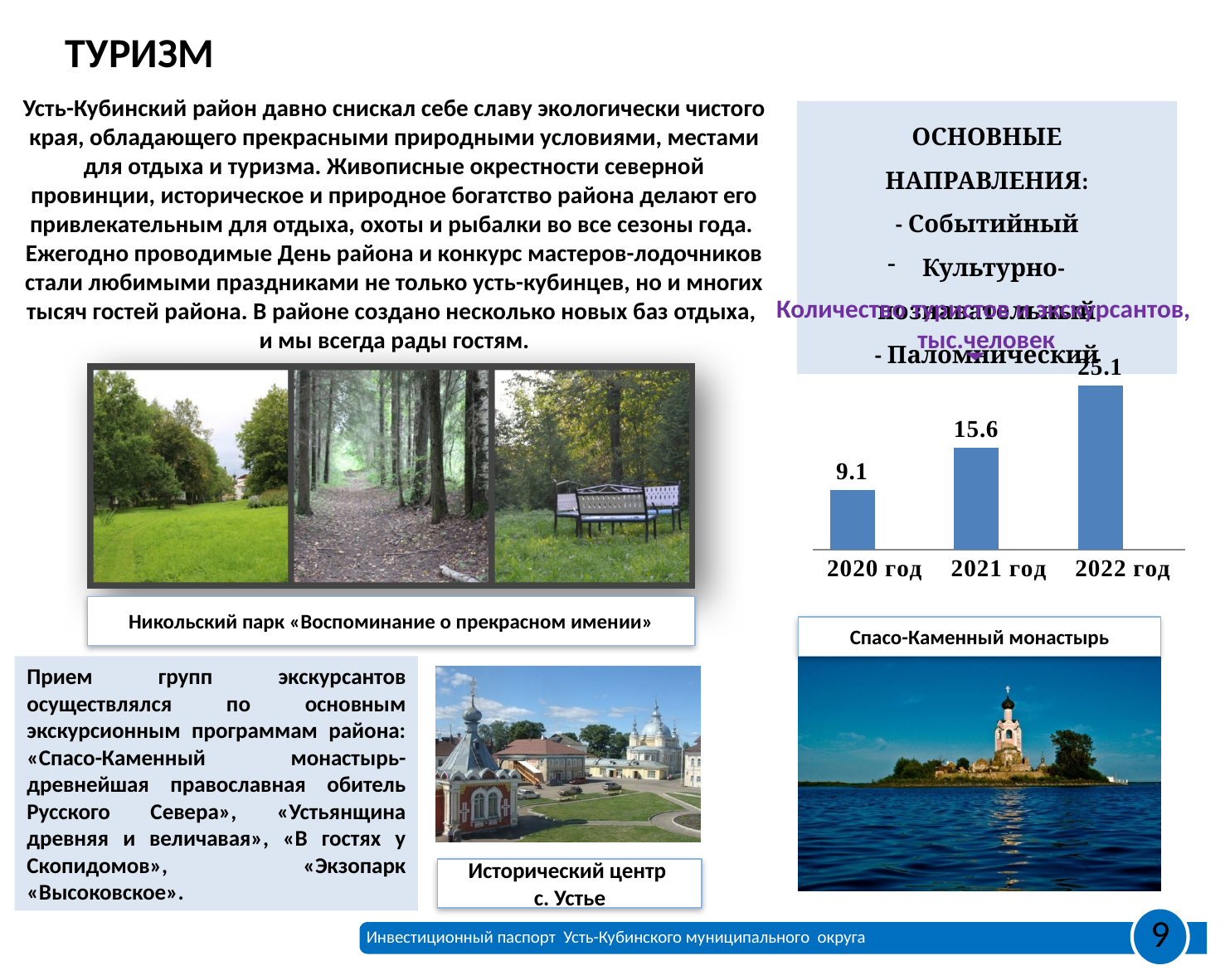
What is the value for 2021 год in the chart? 15.6 What is the value for 2020 год in the chart? 9.1 What is the value for 2022 год in the chart? 25.1 What is the difference between the values for 2022 год and 2021 год? 9.5 How many years are shown in the chart? 3 What is the difference between the values for 2021 год and 2020 год? 6.5 Which is larger, the value for 2021 год or the value for 2020 год? 2021 год What kind of chart is shown on the slide? bar chart Do the values rise or fall from 2020 год to 2022 год? rise What is the title of the chart? Количество туристов и экскурсантов, тыс.человек Which year has the highest value in the chart? 2022 год Which year has the lowest value in the chart? 2020 год